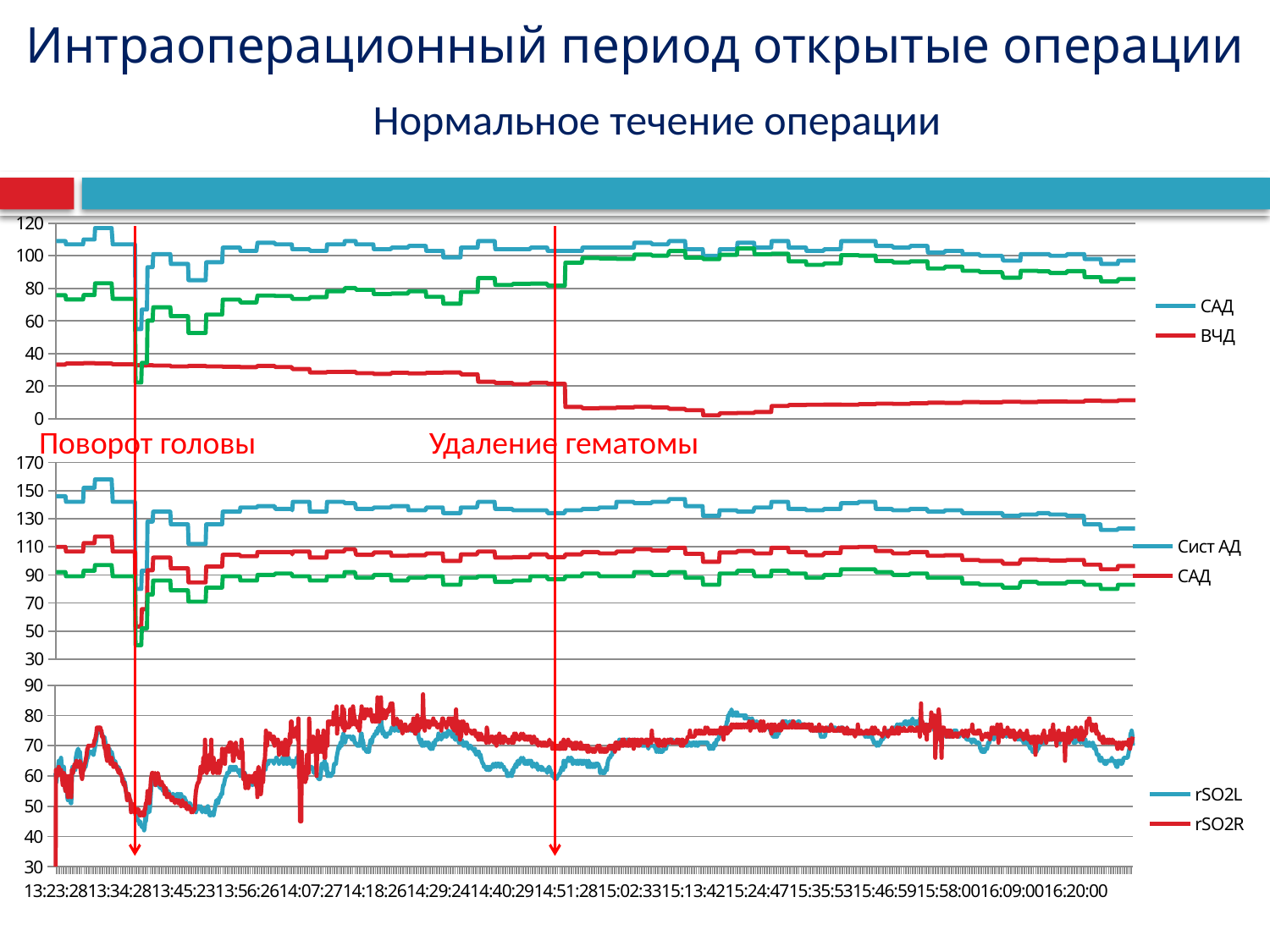
In the top chart, is the value of ВЧД at the end of the recording greater or less than 20? less In the bottom chart, is the lowest value of rSO2L near the 'Поворот головы' marker greater or less than 50? less In the top chart, which series is higher at the end of the recording, САД or ВЧД? САД How many separate charts are shown on the slide? 3 What kind of chart is the top chart on the slide? line chart How many series does the legend of the top chart list? 2 In the top chart, does ВЧД rise or fall over the course of the recording? fall How many series does the legend of the bottom chart list? 2 In the middle chart, is the value of Сист АД at the start of the recording greater or less than 130? greater In the top chart, which two series are named in the legend? САД and ВЧД What event is labelled at the first vertical red line on the slide? Поворот головы